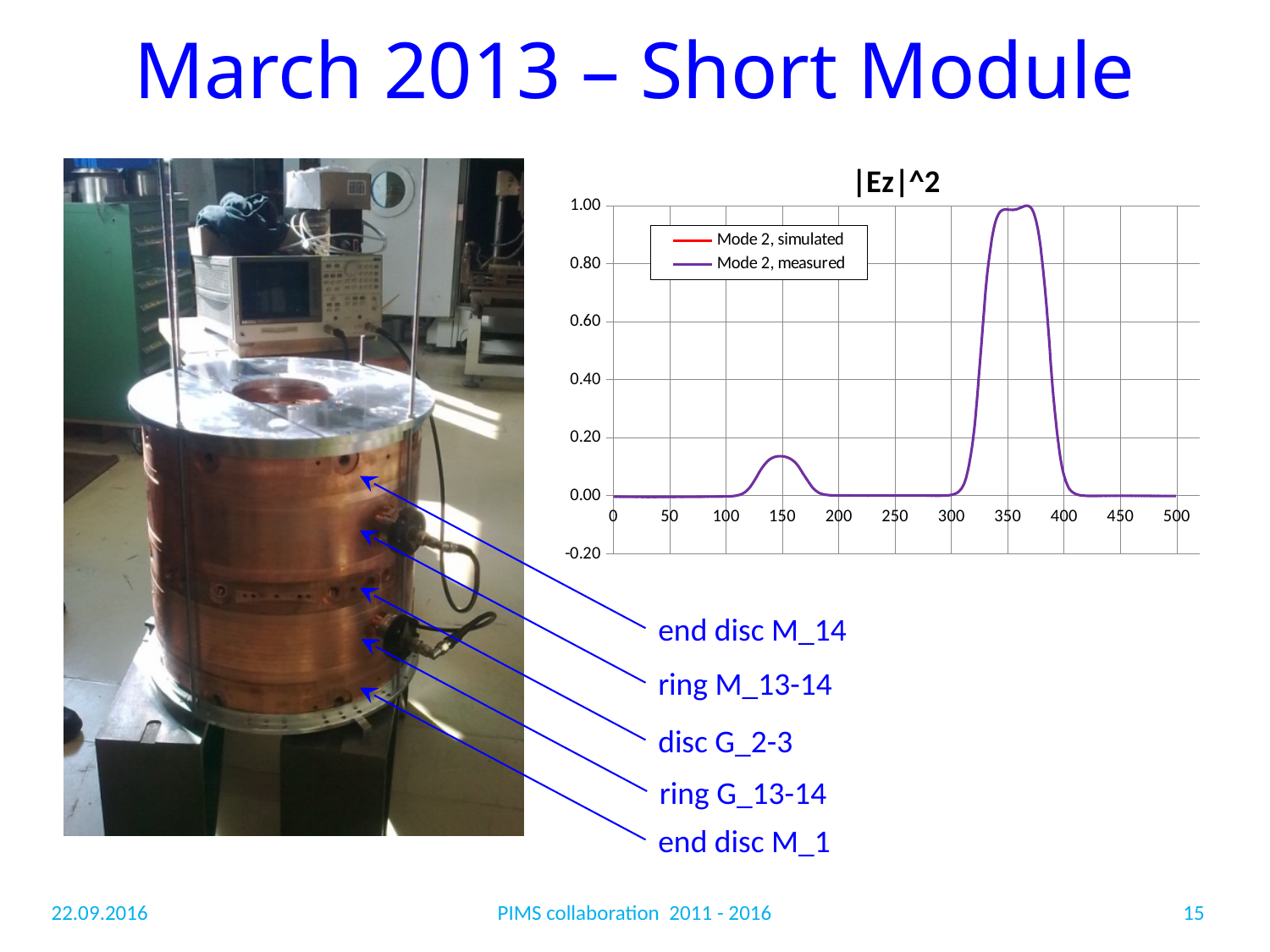
How many series does the legend of the chart list? 2 Which peak of the curve is higher: the one near x = 150 or the one near x = 350? the one near x = 350 Is the value of the measured curve at x = 50 greater or less than 0.20? less Is the value of the measured curve at x = 150 greater or less than 0.20? less Does the curve rise or fall between x = 350 and x = 400? fall Is the value of the measured curve at x = 250 greater or less than 0.20? less What kind of chart is shown on the slide? line chart What is the title of the chart? |Ez|^2 What are the two series named in the chart legend? Mode 2, simulated; Mode 2, measured What is the highest value shown on the x axis of the chart? 500